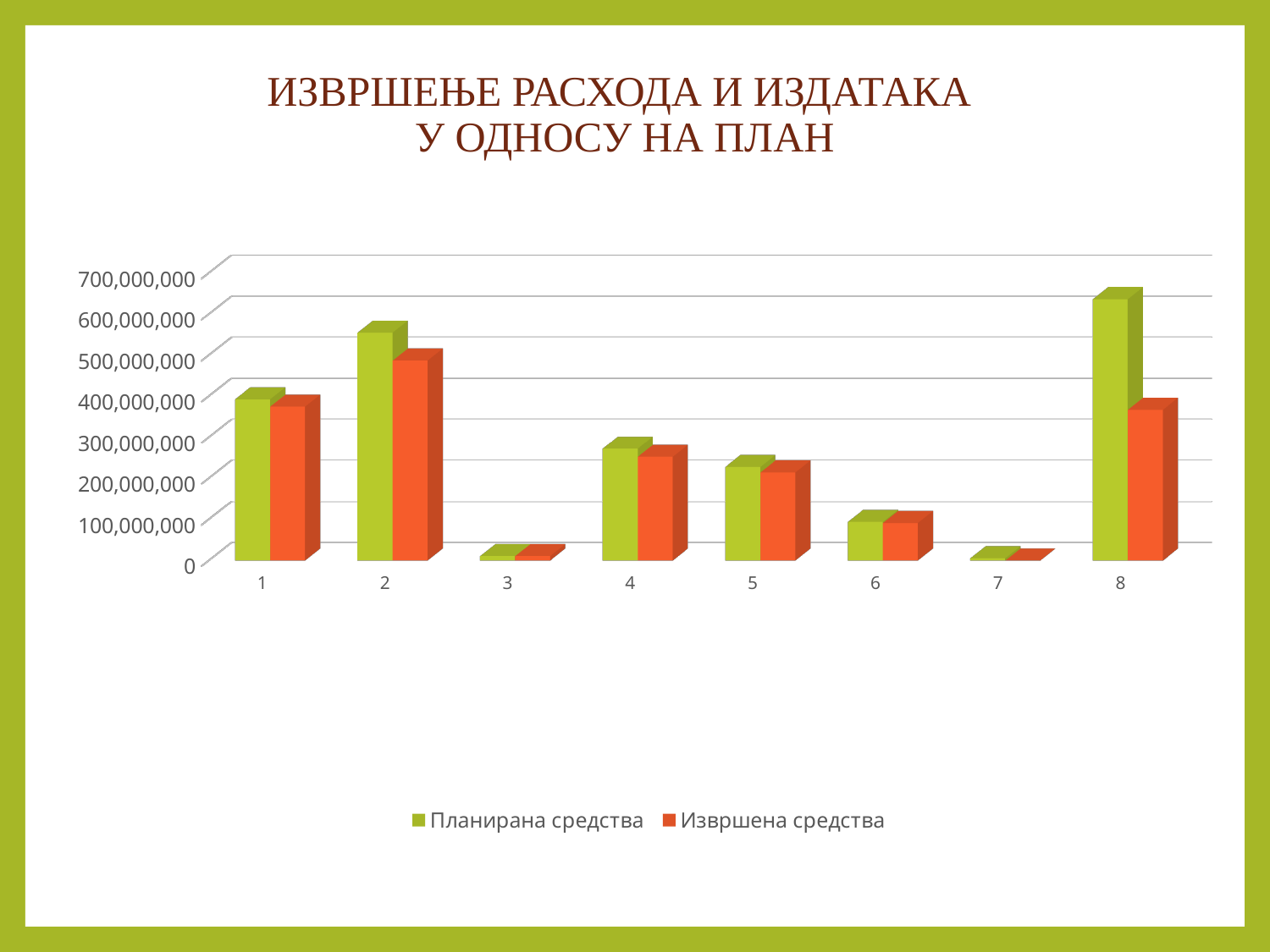
What kind of chart is shown on the slide? bar chart Is the value for Извршена средства in category 8 greater or less than 400,000,000? less Which category has the highest value for Извршена средства? 2 Is the value for Планирана средства in category 2 greater or less than 500,000,000? greater What is the title of the chart? ИЗВРШЕЊЕ РАСХОДА И ИЗДАТАКА У ОДНОСУ НА ПЛАН How many categories are shown on the x axis? 8 Is the value for Извршена средства in category 4 greater or less than 300,000,000? less In category 8, which is larger: Планирана средства or Извршена средства? Планирана средства How many series does the legend list? 2 Which series is shown in orange in the legend? Извршена средства Which category has the highest value for Планирана средства? 8